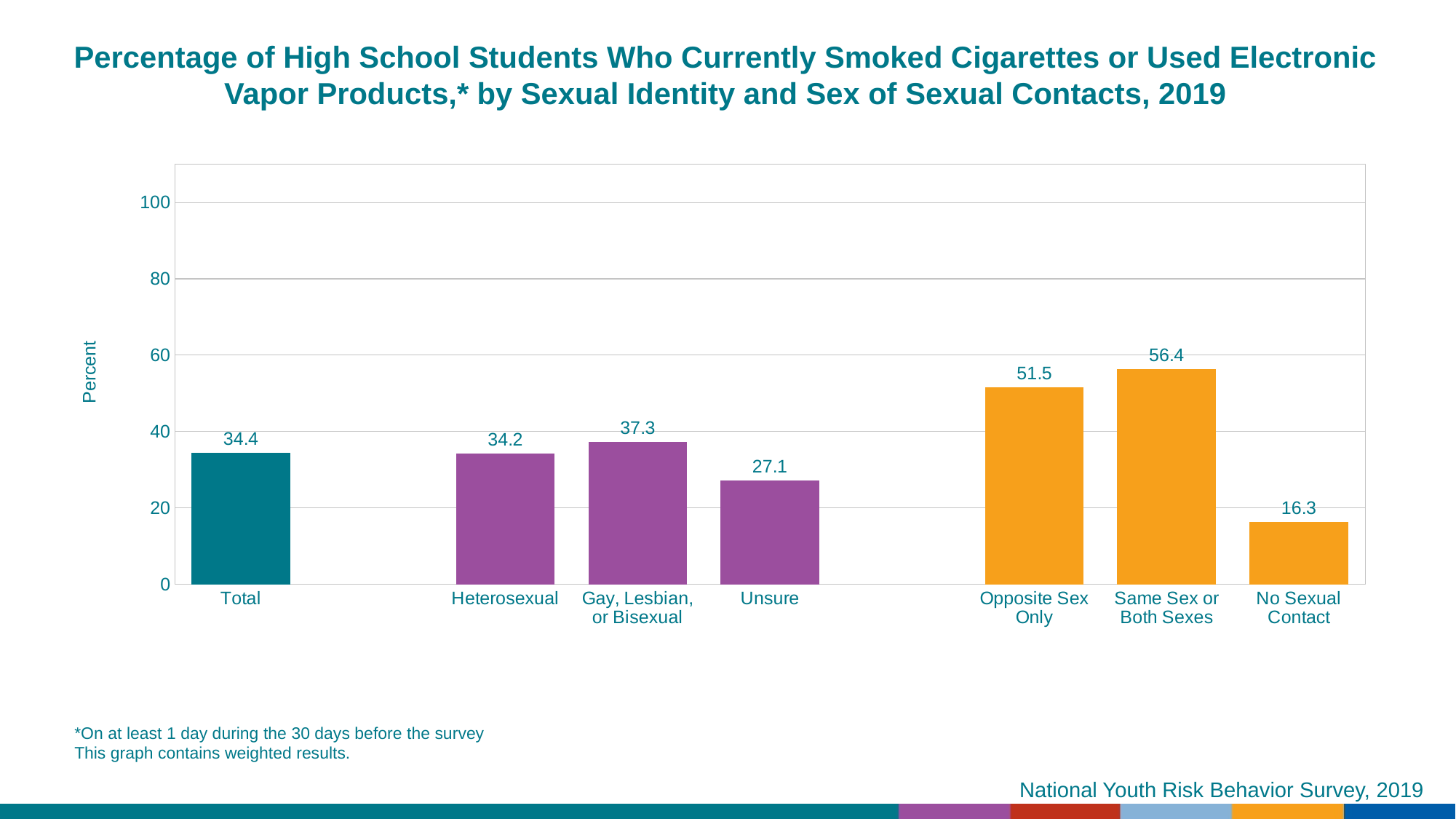
Is the value for Opposite Sex Only greater or less than 40? greater Which category has the lowest value? No Sexual Contact How many categories are shown in the chart? 7 Which is larger, the value for Opposite Sex Only or the value for Unsure? Opposite Sex Only What is the value for Same Sex or Both Sexes? 56.4 What is the difference between the values for Gay, Lesbian, or Bisexual and Heterosexual? 3.1 What is the value for Unsure? 27.1 Which category has the highest value? Same Sex or Both Sexes What kind of chart is shown on the slide? Bar chart What is the value for Total? 34.4 What is the difference between the values for Same Sex or Both Sexes and Opposite Sex Only? 4.9 What is the value for No Sexual Contact? 16.3